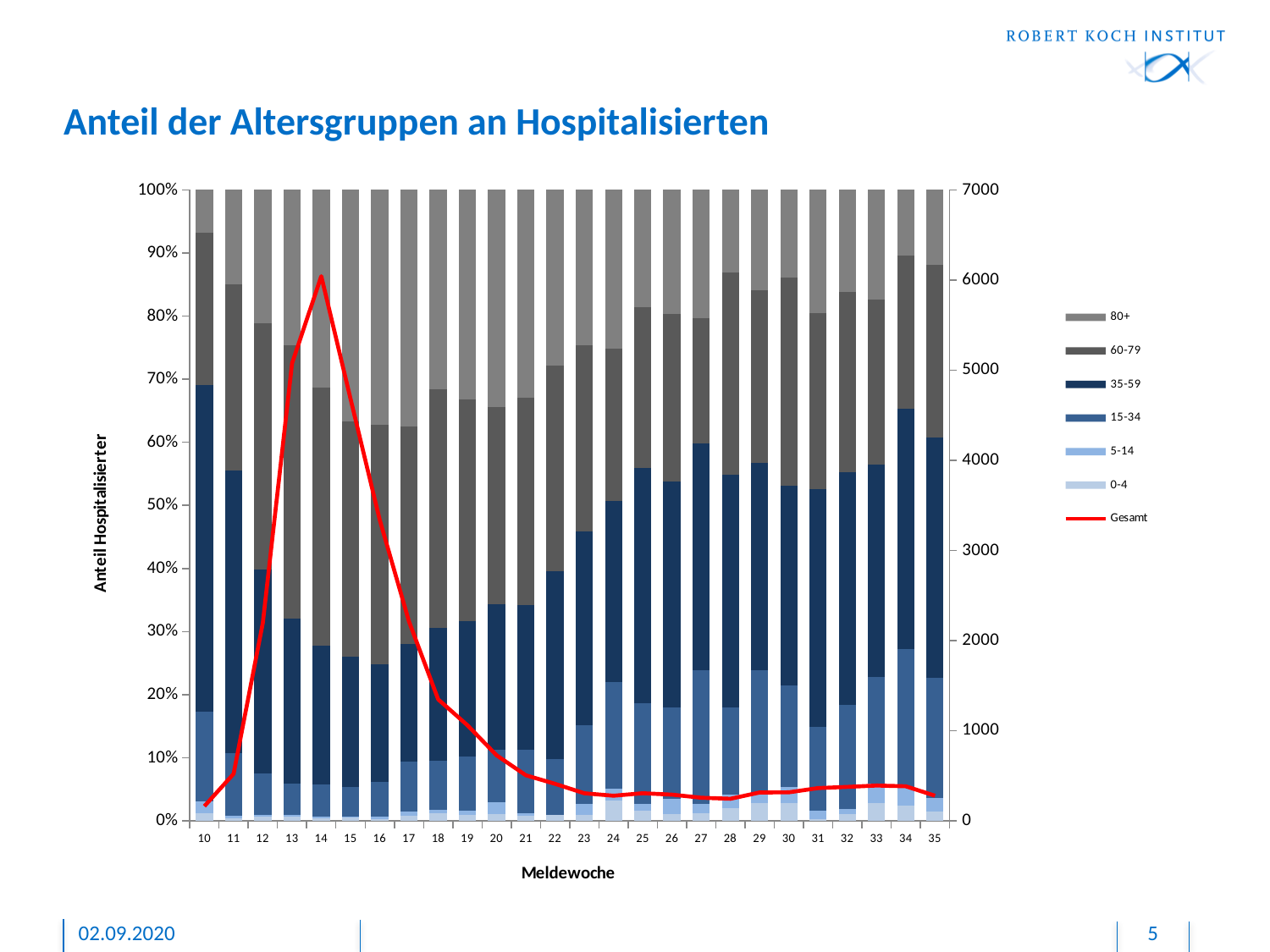
How many Meldewoche categories are shown on the x axis? 26 Is the Gesamt value in Meldewoche 35 greater or less than 1000? less Is the share of the 80+ group in Meldewoche 10 greater or less than 10%? less Does the Gesamt line rise or fall from Meldewoche 14 to Meldewoche 22? fall What is the title of the chart? Anteil der Altersgruppen an Hospitalisierten Is the Gesamt value in Meldewoche 14 greater or less than 5000? greater What is the label of the x axis? Meldewoche In which Meldewoche does the Gesamt line reach its highest value? 14 Which is larger, the Gesamt value in Meldewoche 14 or in Meldewoche 20? Meldewoche 14 What kind of chart is shown on the slide? stacked bar chart with a line How many series does the legend list? 7